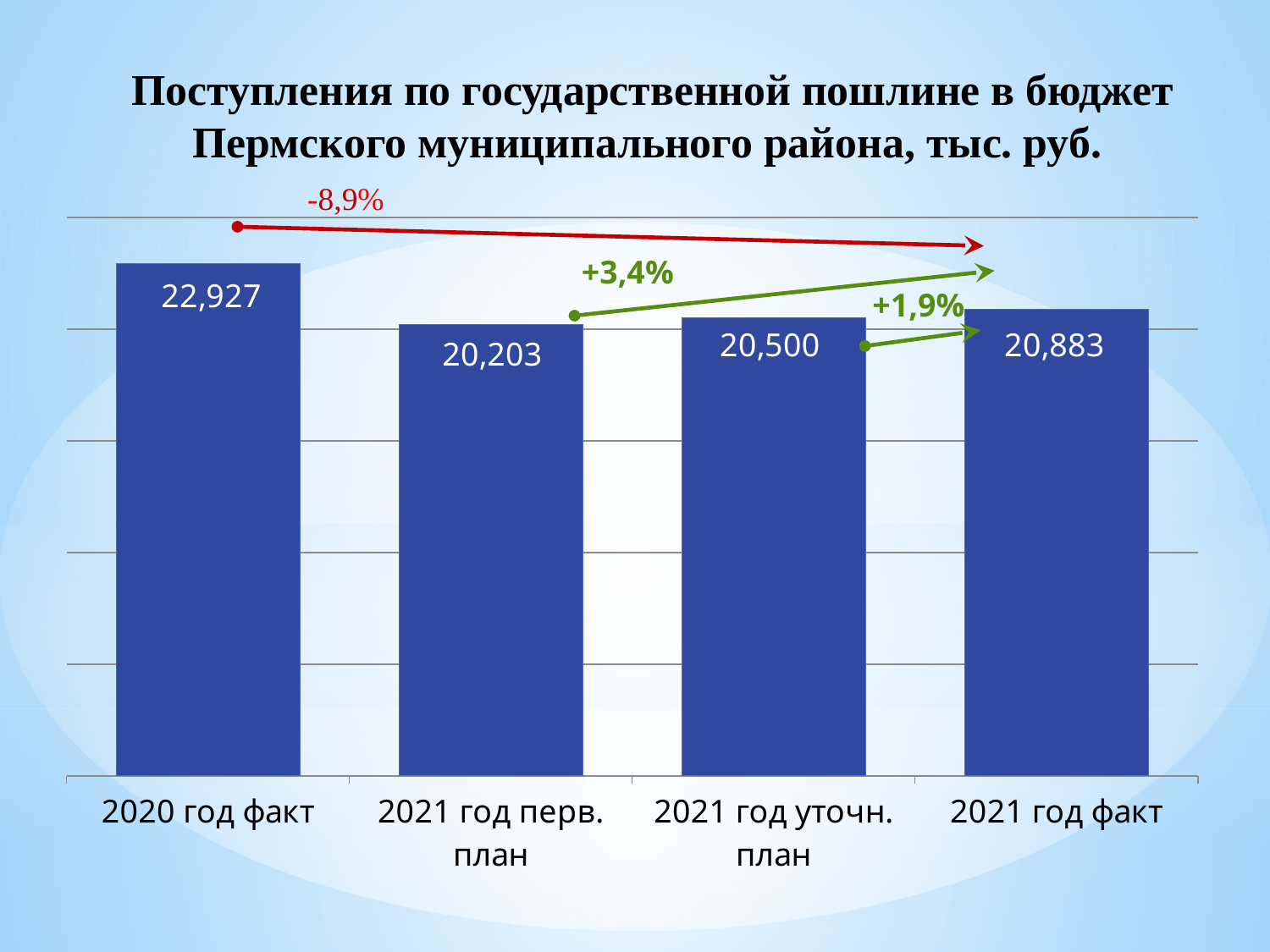
What kind of chart is shown on the slide? Bar chart What is the value for 2021 год перв. план? 20,203 What percentage change is shown by the red arrow from 2020 год факт to 2021 год факт? -8,9% What is the value for 2021 год уточн. план? 20,500 What is the value for 2021 год факт? 20,883 How many categories are shown on the chart? 4 What is the difference between the values for 2021 год факт and 2021 год уточн. план? 383 What is the value for 2020 год факт? 22,927 Which is larger, the value for 2021 год уточн. план or 2021 год перв. план? 2021 год уточн. план What is the difference between the values for 2020 год факт and 2021 год факт? 2,044 Which category has the lowest value? 2021 год перв. план Which category has the highest value? 2020 год факт